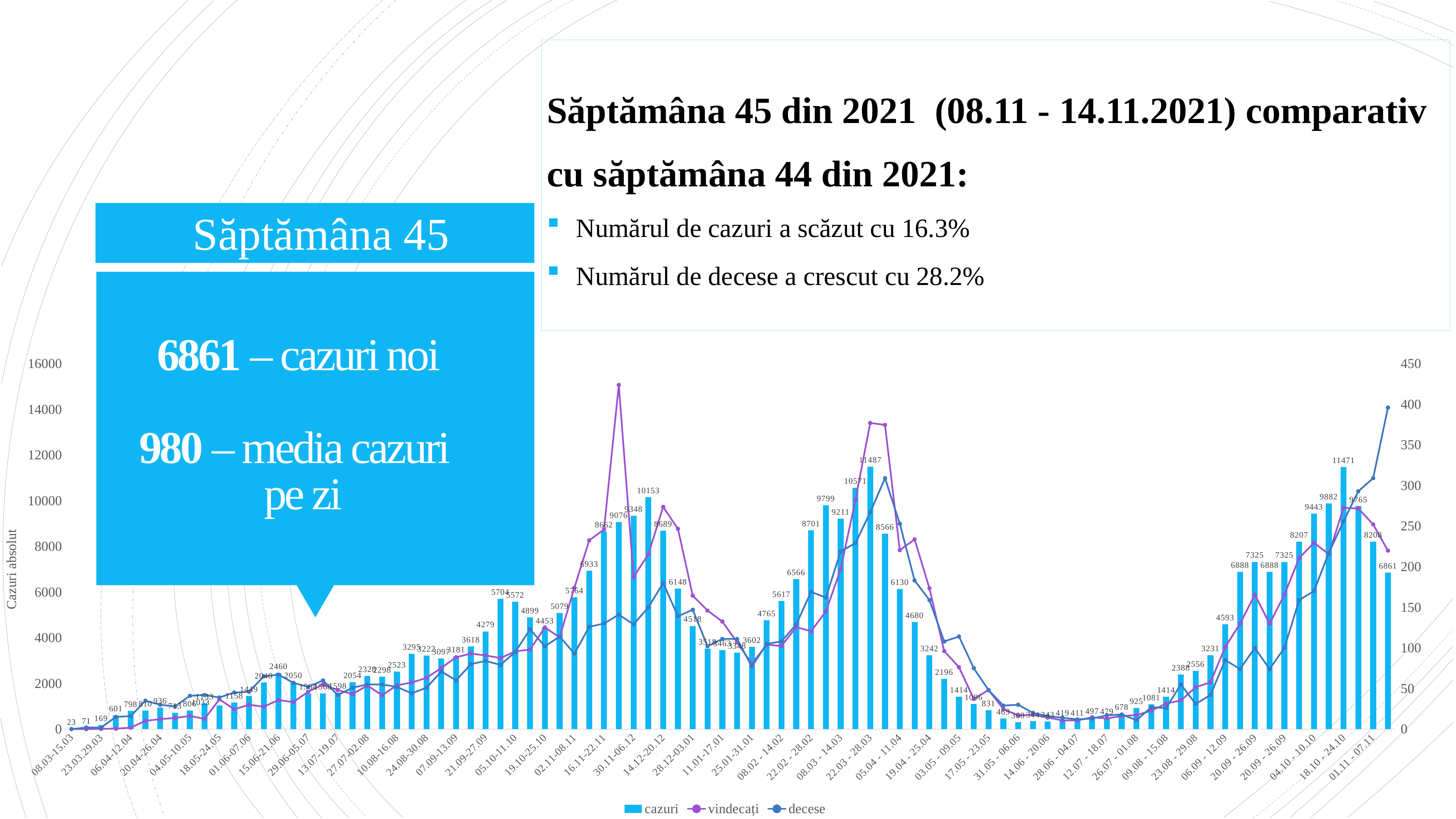
What is the difference between the highest cazuri bar (11487) and the last cazuri bar (6861)? 4626 What is the lowest value labelled on the cazuri bars? 23 How many series does the chart legend list? 3 What is the value labelled on the last (rightmost) cazuri bar? 6861 Which series is plotted as bars in the chart? cazuri Which is larger, the cazuri bar labelled 10153 or the one labelled 9799? 10153 Do the cazuri bar values rise or fall over the first four bars (23, 71, 169, 601)? rise What kind of chart is shown on the slide? A combined bar and line chart What is the highest value labelled on the cazuri bars? 11487 What is the title of the left vertical axis? Cazuri absolut Is the final value of the decese line greater or less than 350 on the right-hand axis? greater